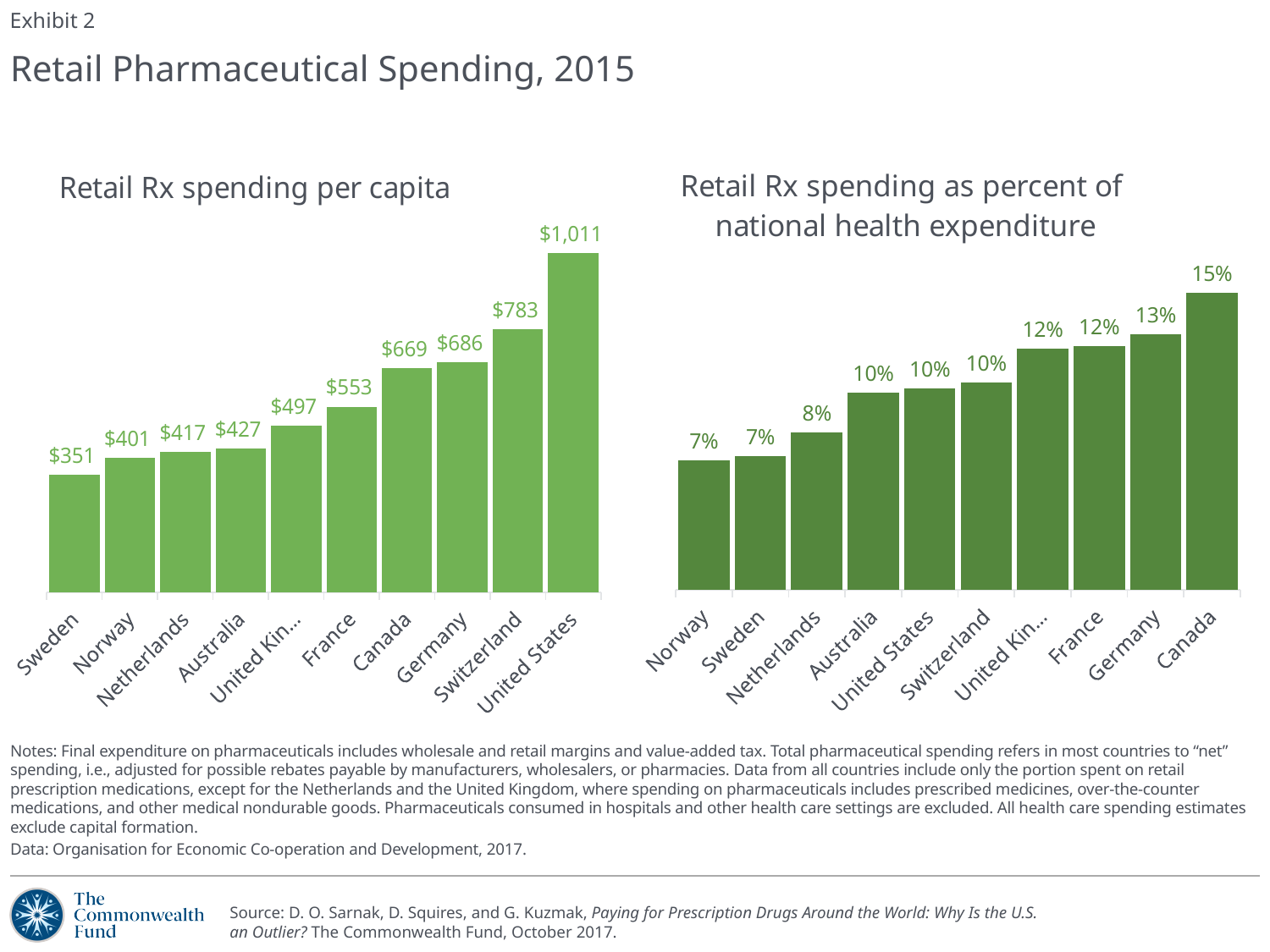
In the 'Retail Rx spending as percent of national health expenditure' chart, which is larger, the value for Germany or the value for Australia? Germany In the 'Retail Rx spending per capita' chart, which country has the lowest spending? Sweden In the 'Retail Rx spending as percent of national health expenditure' chart, what is the difference between Canada and Netherlands? 7% In the 'Retail Rx spending as percent of national health expenditure' chart, do the values rise or fall from left to right? Rise In the 'Retail Rx spending per capita' chart, which is larger, the value for Norway or the value for France? France In the 'Retail Rx spending as percent of national health expenditure' chart, which country has the highest value? Canada In the 'Retail Rx spending per capita' chart, what is the difference between Switzerland and Germany? $97 In the 'Retail Rx spending per capita' chart, what is the value for Canada? $669 In the 'Retail Rx spending as percent of national health expenditure' chart, what is the value for the United States? 10% In the 'Retail Rx spending per capita' chart, how many countries are shown? 10 In the 'Retail Rx spending per capita' chart, what is the value for the United States? $1,011 What kind of chart is the 'Retail Rx spending per capita' chart? Bar chart